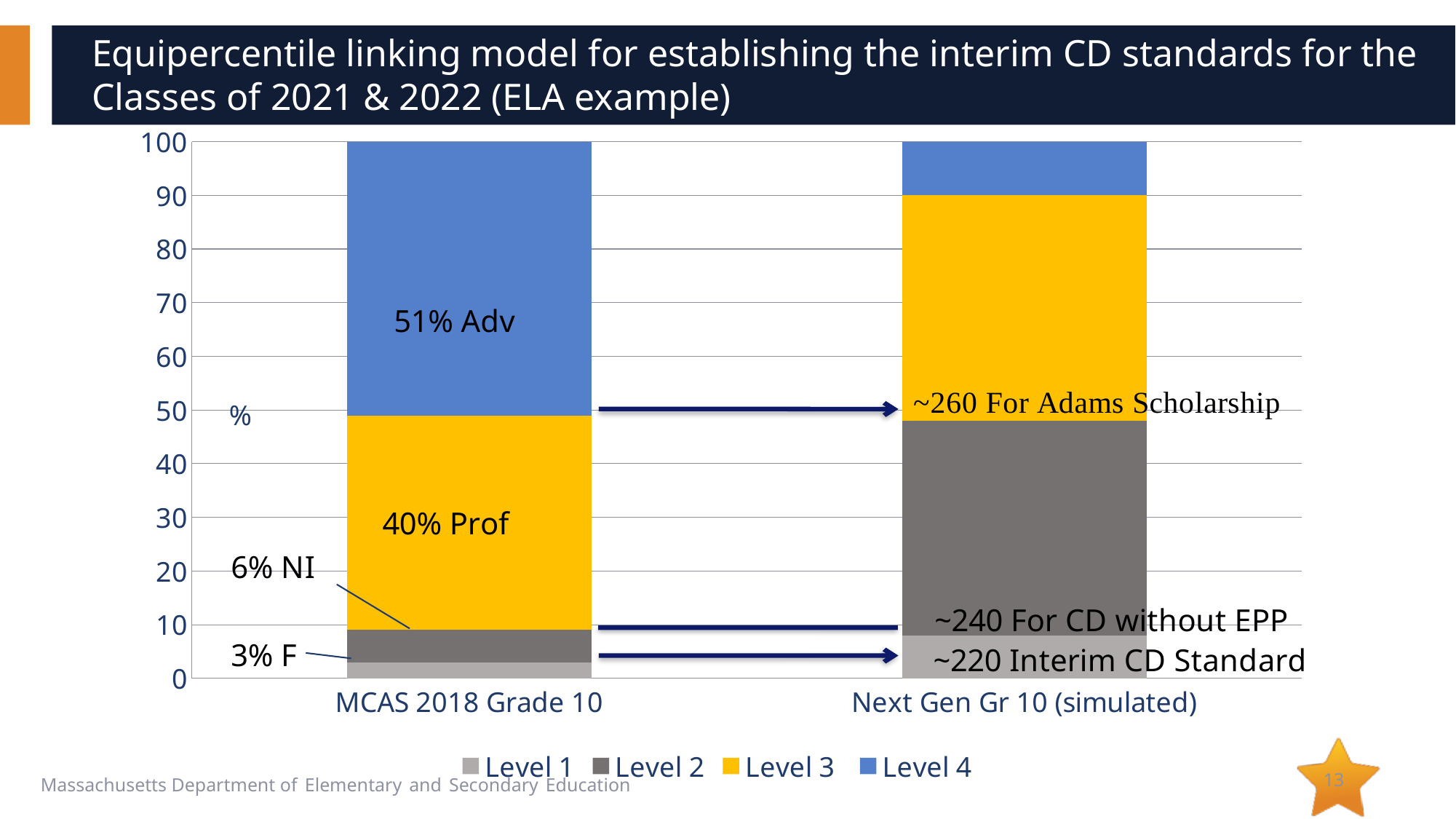
What is the value of the NI segment for MCAS 2018 Grade 10? 6% How many series does the legend list? 4 Which bar has the larger Level 4 segment, MCAS 2018 Grade 10 or Next Gen Gr 10 (simulated)? MCAS 2018 Grade 10 Is the Level 4 segment in the Next Gen Gr 10 (simulated) bar greater or less than 20? less What is the value of the Level 4 (Adv) segment for MCAS 2018 Grade 10? 51% What is the value of the Level 3 (Prof) segment for MCAS 2018 Grade 10? 40% What is the difference between the Adv and Prof percentages in the MCAS 2018 Grade 10 bar? 11% How many categories (bars) are shown on the x axis? 2 Is the Level 2 segment in the Next Gen Gr 10 (simulated) bar greater or less than 30? greater What kind of chart is shown on the slide? Stacked bar chart Which level has the smallest segment in the MCAS 2018 Grade 10 bar? Level 1 Which level has the largest segment in the MCAS 2018 Grade 10 bar? Level 4